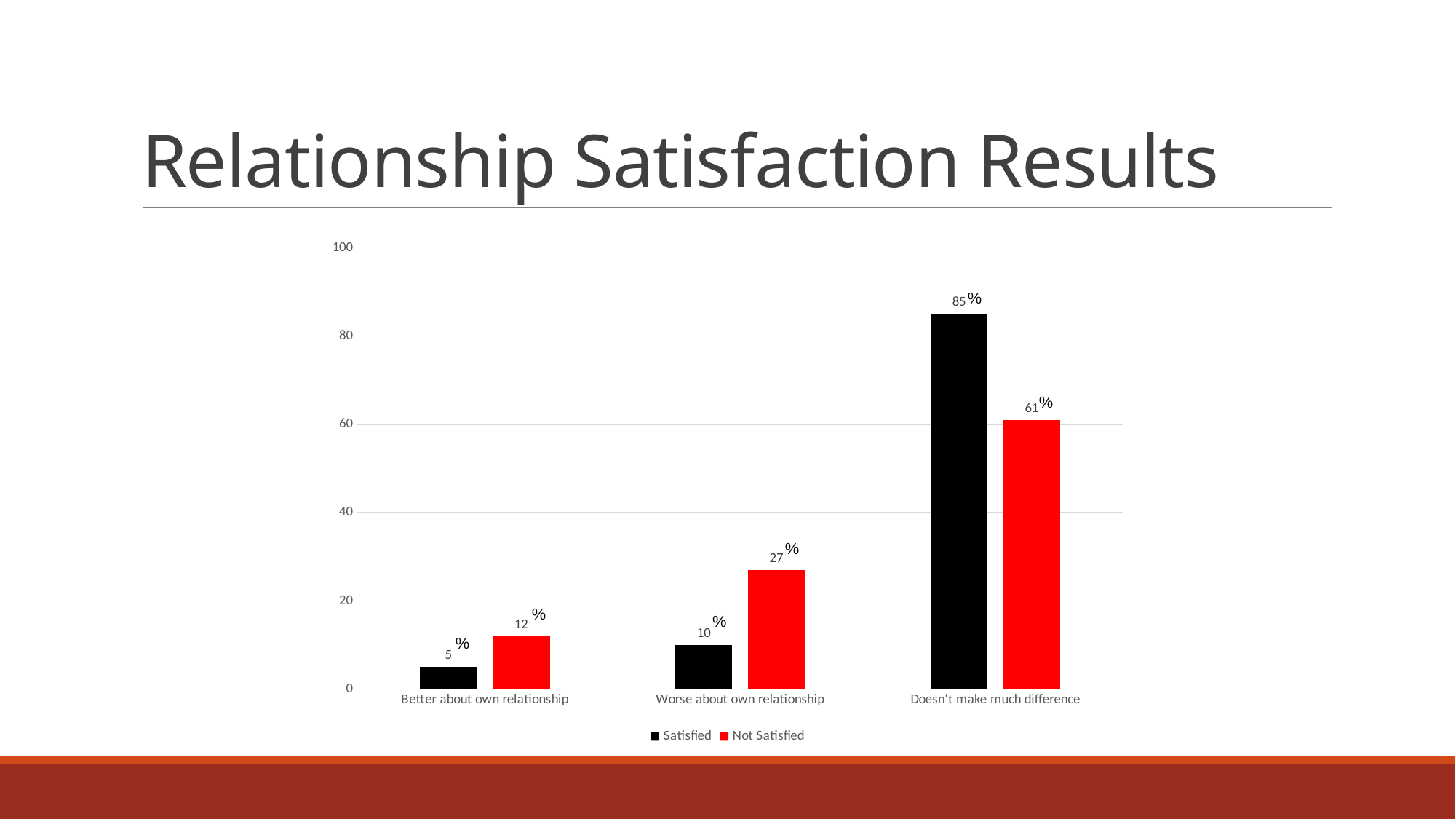
Which category has the highest Satisfied value? Doesn't make much difference Which category has the lowest Not Satisfied value? Better about own relationship How many categories are shown on the x axis? 3 What is the Not Satisfied value for "Worse about own relationship"? 27% What is the difference between the Satisfied and Not Satisfied values for "Doesn't make much difference"? 24% What is the Satisfied value for "Doesn't make much difference"? 85% For "Worse about own relationship", which is larger: Satisfied or Not Satisfied? Not Satisfied How many series does the legend list? 2 What is the Satisfied value for "Better about own relationship"? 5% What kind of chart is shown on the slide? Bar chart What is the Not Satisfied value for "Doesn't make much difference"? 61% Is the Not Satisfied value for "Doesn't make much difference" greater or less than 80? less